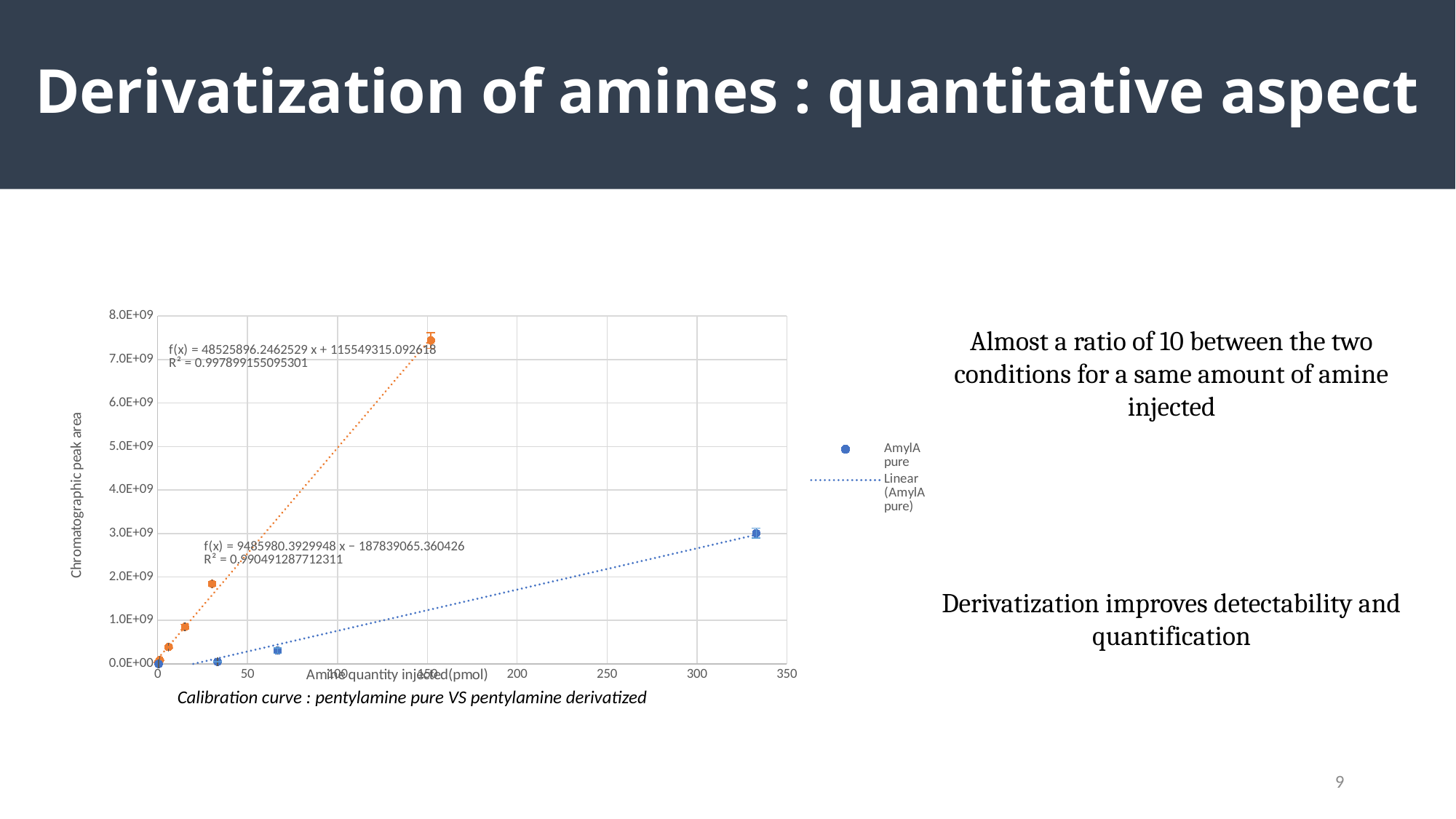
Is the chromatographic peak area of the blue point at about 333 pmol greater or less than 2.0E+09? greater Which trendline has the higher R² value, the upper (orange) one or the lower (blue) one? The upper (orange) one Is the chromatographic peak area of the orange point at about 150 pmol greater or less than 6.0E+09? greater What is the caption printed below the chart? Calibration curve : pentylamine pure VS pentylamine derivatized What is the slope printed in the equation of the lower (blue) trendline? 9485980.3929948 Do the chromatographic peak area values rise or fall as the amine quantity injected increases? Rise How many entries does the chart legend list? 2 What is the label of the y axis of the chart? Chromatographic peak area What is the R² value printed for the upper (orange) trendline? 0.997899155095301 What kind of chart is shown on the slide? Scatter chart What is the slope printed in the equation of the upper (orange) trendline? 48525896.2462529 What is the R² value printed for the lower (blue) trendline? 0.990491287712311